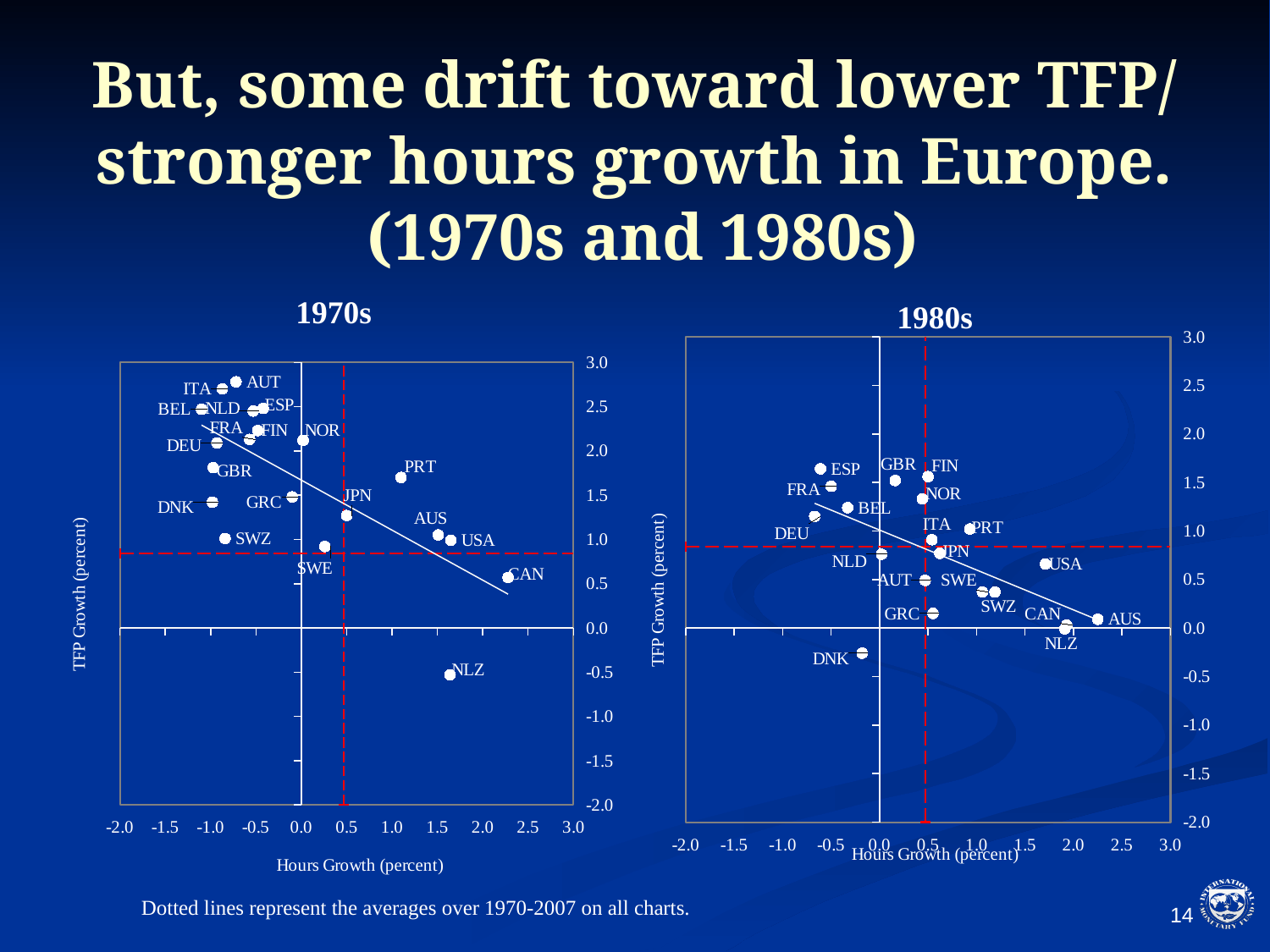
In the 1980s chart, is the hours growth for ESP greater or less than 0.0? less In the 1970s chart, is the TFP growth for NLZ greater or less than 0.0? less What is the label on the horizontal axis of the 1980s chart? Hours Growth (percent) In the 1980s chart, which country has the lowest TFP growth? DNK In the 1970s chart, which country has the highest hours growth? CAN In the 1970s chart, which country has the lowest TFP growth? NLZ In the 1970s chart, is the TFP growth for AUT greater or less than 2.5? greater In the 1980s chart, which has higher TFP growth, USA or DNK? USA In the 1980s chart, which country has the highest hours growth? AUS What kind of chart is the 1970s chart? scatter chart In the 1970s chart, which has higher TFP growth, PRT or USA? PRT